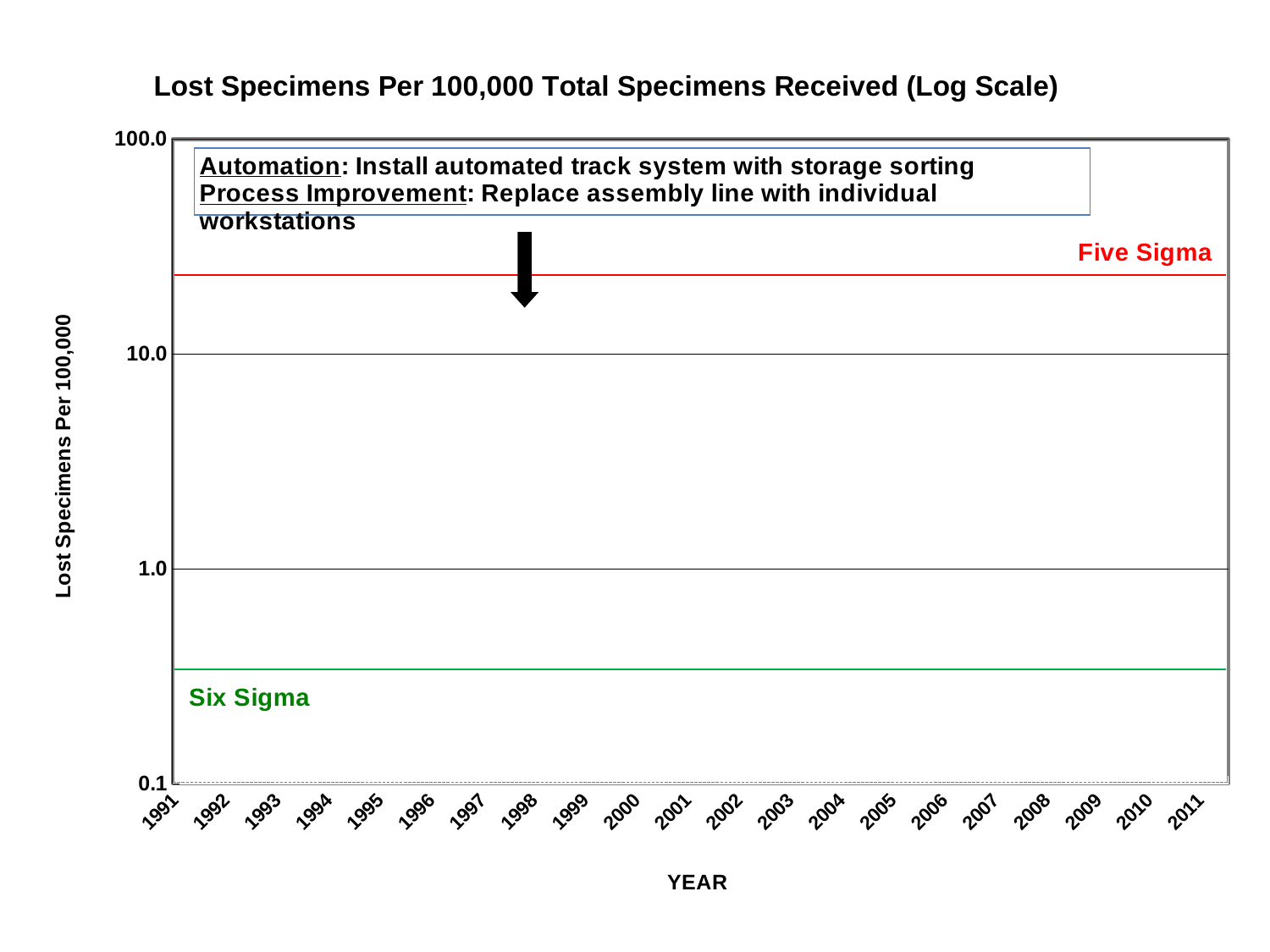
How many years are shown along the x axis of the chart? 21 What is the lowest value labelled on the y axis? 0.1 Is the Five Sigma reference line greater or less than 10.0 on the y axis? greater What is the last year shown on the x axis? 2011 Which reference line sits higher on the chart, Five Sigma or Six Sigma? Five Sigma What is the first year shown on the x axis? 1991 What is the highest value labelled on the y axis? 100.0 What is the title of the chart? Lost Specimens Per 100,000 Total Specimens Received (Log Scale) What is the label on the x axis of the chart? YEAR Is the Six Sigma reference line greater or less than 1.0 on the y axis? less What kind of chart is shown on the slide? line chart